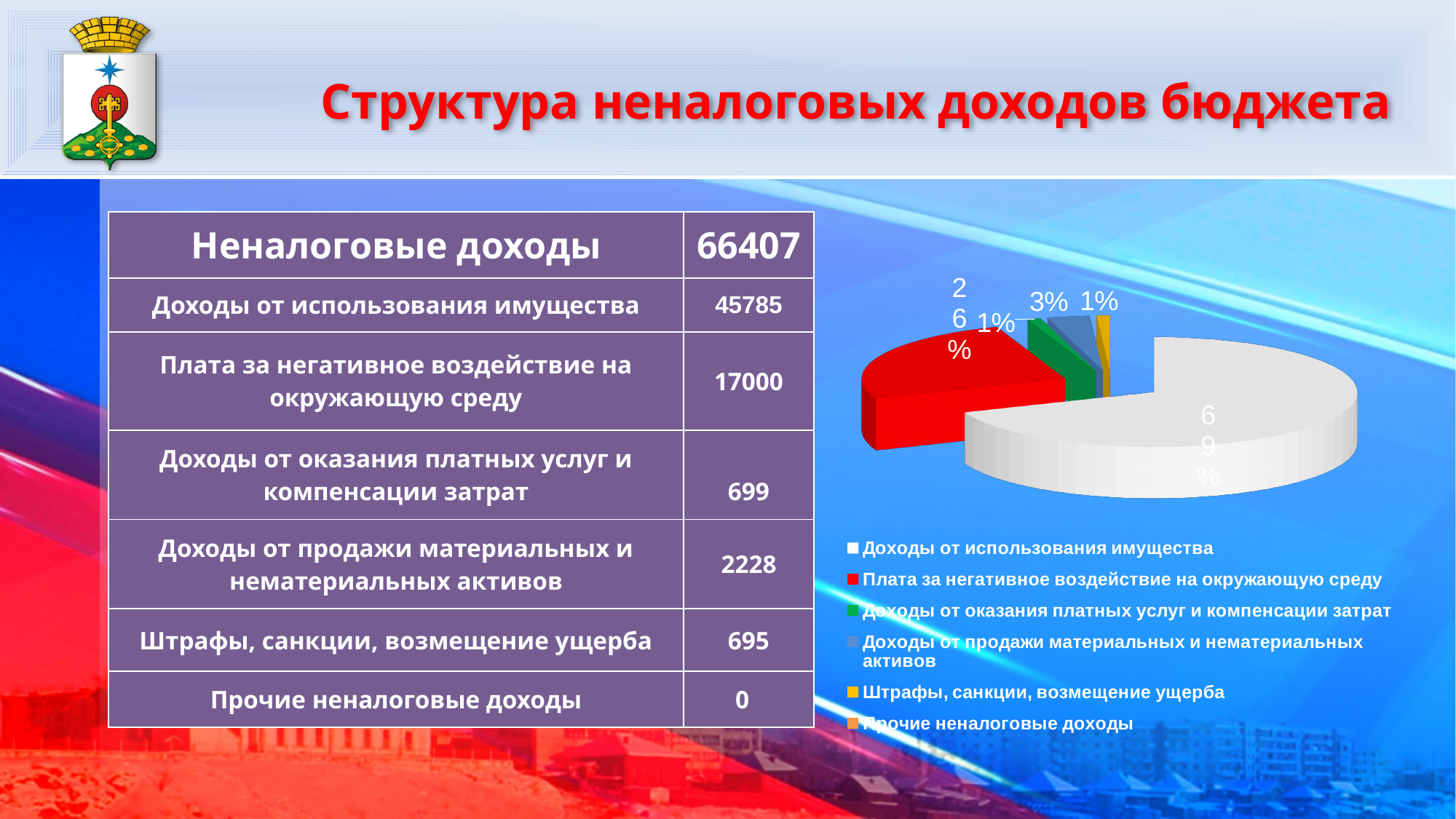
How many entries does the pie chart legend list? 6 What percentage is shown for "Доходы от продажи материальных и нематериальных активов" in the pie chart? 3% What share of the pie does "Доходы от использования имущества" take? 69% What share of the pie does "Плата за негативное воздействие на окружающую среду" take? 26% What percentage is shown for "Штрафы, санкции, возмещение ущерба" in the pie chart? 1% What is the title of the slide containing the pie chart? Структура неналоговых доходов бюджета What colour is the slice for "Плата за негативное воздействие на окружающую среду"? red What percentage is shown for "Доходы от оказания платных услуг и компенсации затрат" in the pie chart? 1% What kind of chart is shown on the slide? pie chart By how many percentage points does the "Доходы от использования имущества" slice exceed the "Плата за негативное воздействие на окружающую среду" slice? 43% Which category has the largest slice of the pie? Доходы от использования имущества Which slice is larger: "Плата за негативное воздействие на окружающую среду" or "Доходы от продажи материальных и нематериальных активов"? Плата за негативное воздействие на окружающую среду